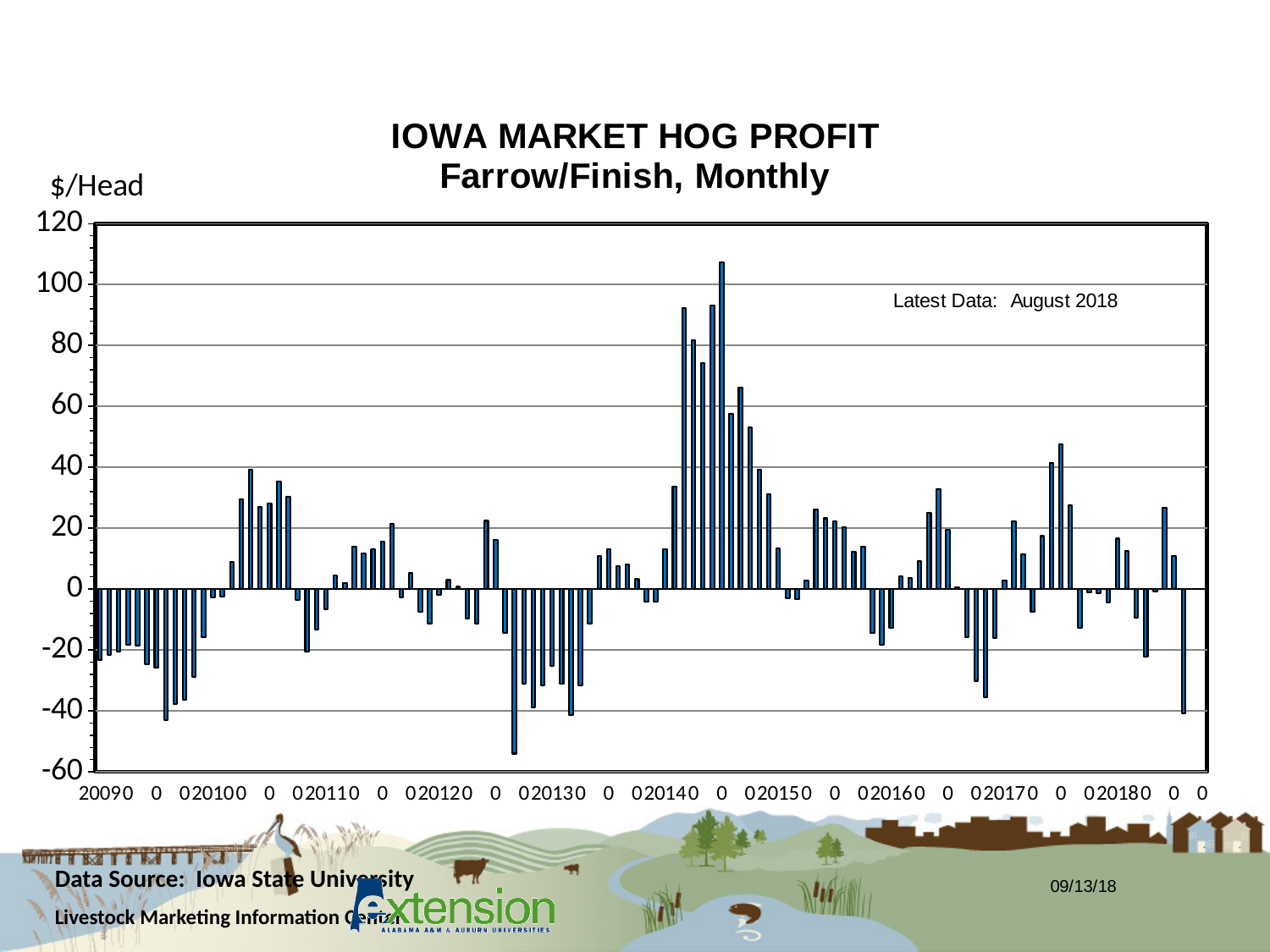
In which year does the highest bar on the chart occur? 2014 Is the highest bar in 2017 greater or less than 40? greater What is the title of the chart? IOWA MARKET HOG PROFIT Farrow/Finish, Monthly What kind of chart is shown on the slide? bar chart Is the value of the last bar (August 2018) greater or less than -20? less Which year has the larger peak bar, 2014 or 2017? 2014 How many years are labeled along the x axis? 10 In which year does the lowest bar on the chart occur? 2012 According to the note on the chart, what is the latest data month? August 2018 Is the lowest bar on the chart greater or less than -40? less